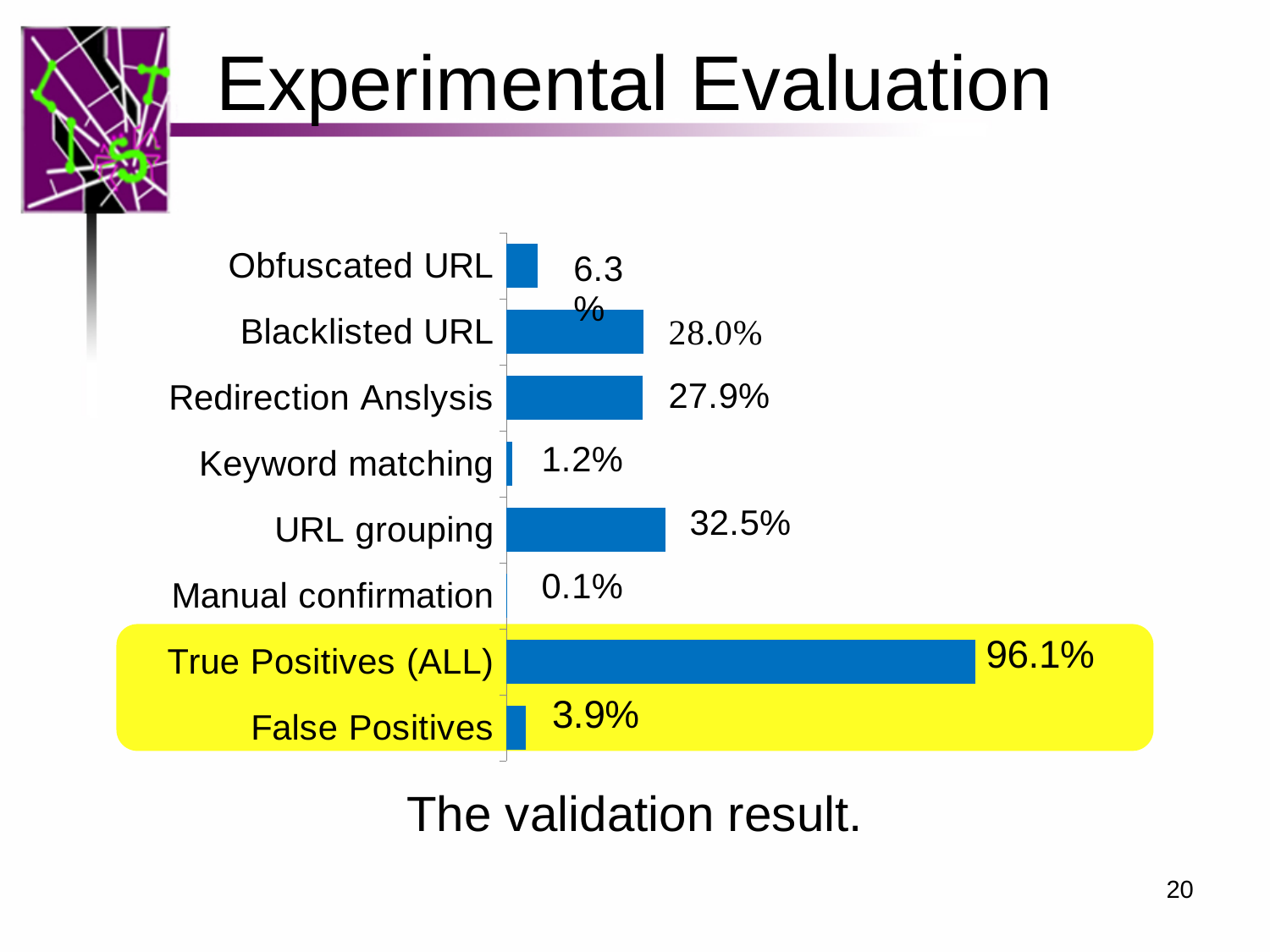
What is the difference between Blacklisted URL and Redirection Anslysis? 0.1% What is the value for Manual confirmation? 0.1% What is the value for Keyword matching? 1.2% Which category has the lowest value? Manual confirmation Which is larger, URL grouping or Obfuscated URL? URL grouping What is the value for False Positives? 3.9% Which category has the highest value? True Positives (ALL) How many categories are shown in the chart? 8 What is the difference between True Positives (ALL) and False Positives? 92.2% What is the value for URL grouping? 32.5% What kind of chart is shown on the slide? Bar chart What is the value for True Positives (ALL)? 96.1%